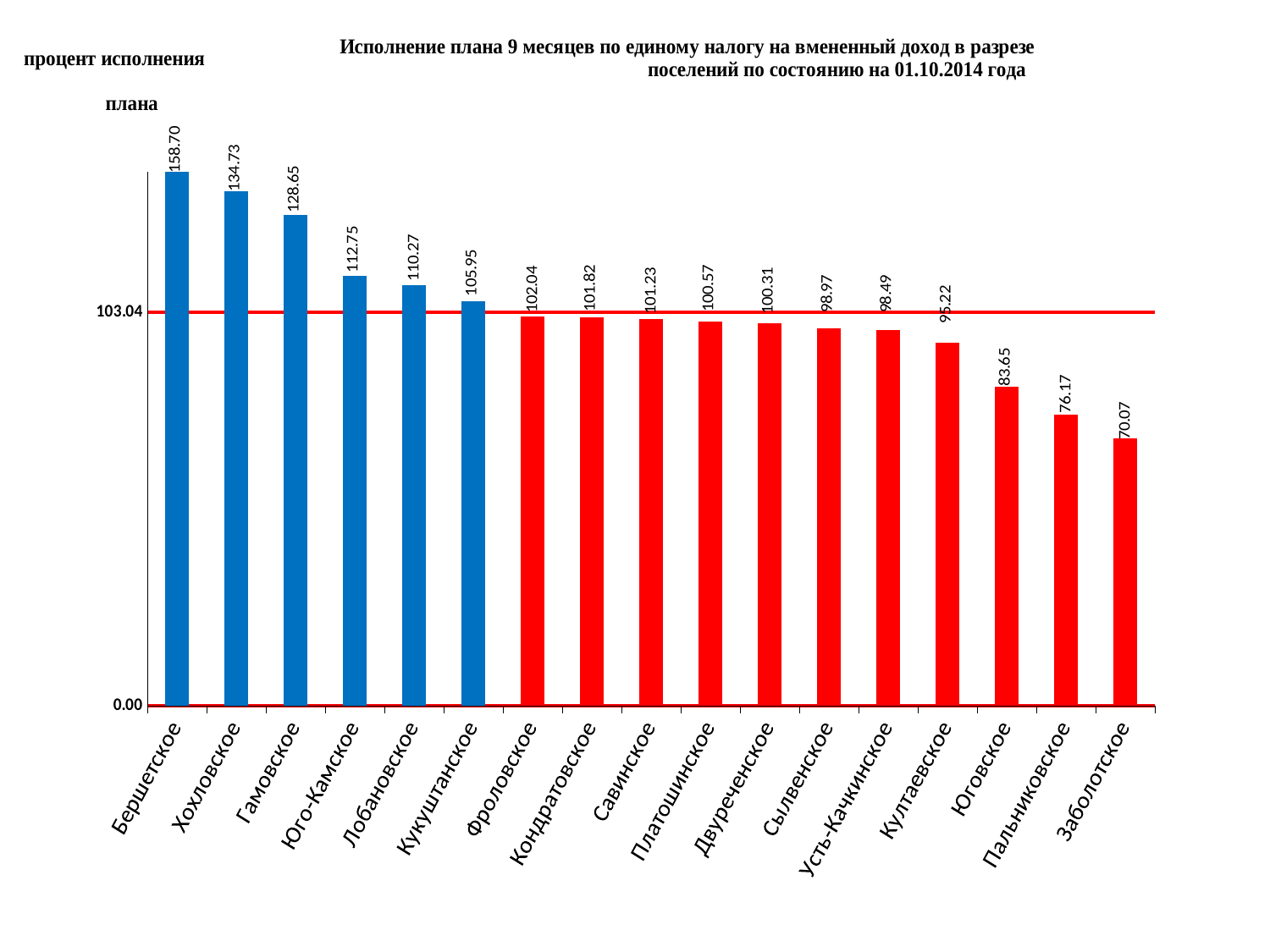
What is the difference between the values for Бершетское and Заболотское? 88.63 What is the value for Култаевское? 95.22 How many categories are shown on the x axis? 17 What value is marked by the horizontal red line across the chart? 103.04 What is the value for Заболотское? 70.07 What is the value for Бершетское? 158.70 Which category has the highest value? Бершетское What is the value for Фроловское? 102.04 What kind of chart is this? Bar chart Which category has the lowest value? Заболотское What is the difference between the values for Хохловское and Гамовское? 6.08 Which is larger, the value for Юго-Камское or the value for Юговское? Юго-Камское